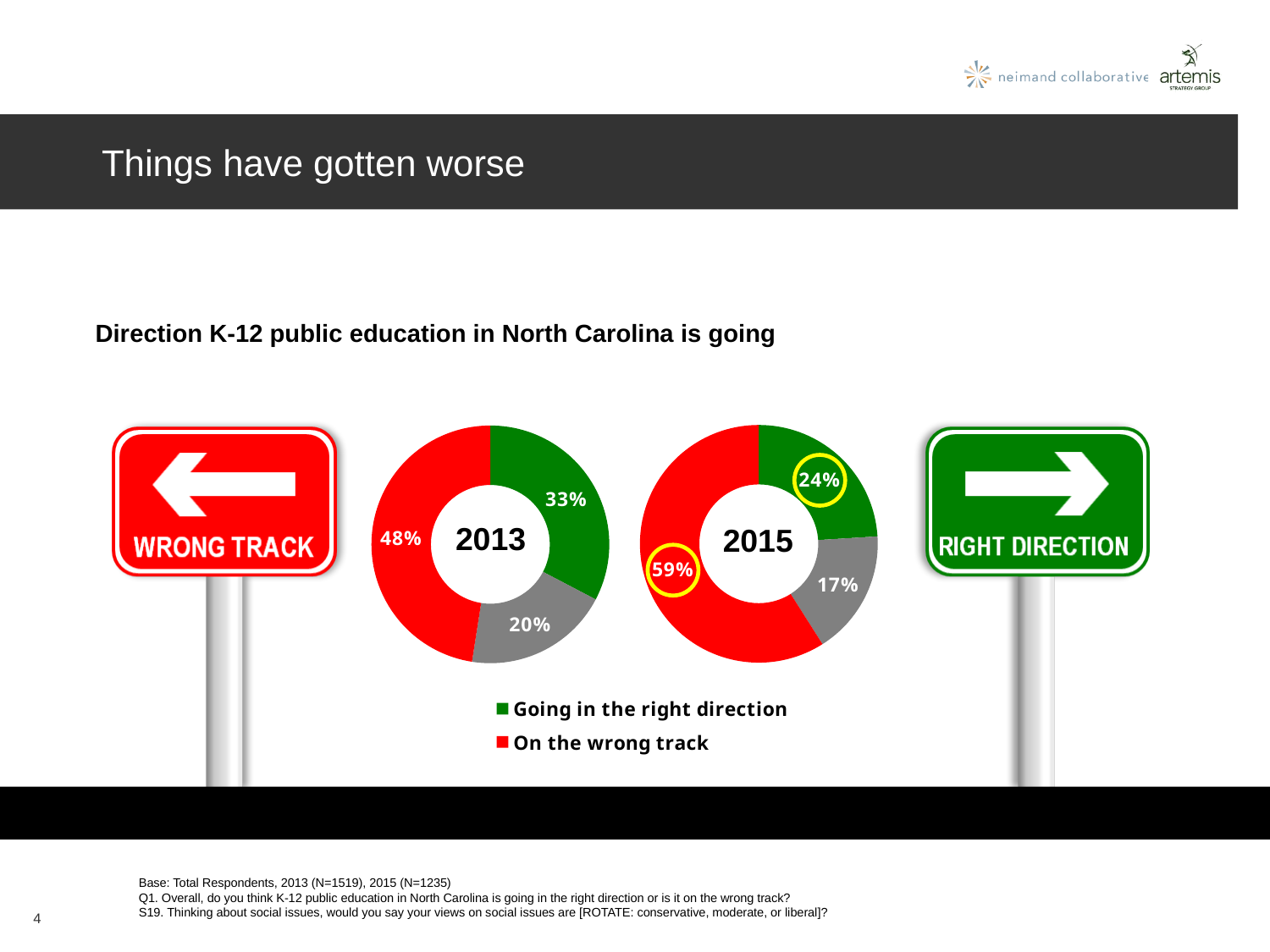
In the 2015 donut chart, what percentage said K-12 public education is on the wrong track? 59% In the 2015 donut chart, which slice is the largest? On the wrong track In the 2015 donut chart, what percentage said K-12 public education is going in the right direction? 24% In the 2013 donut chart, what percentage said K-12 public education is on the wrong track? 48% By how many percentage points did the 'Going in the right direction' share fall from the 2013 chart to the 2015 chart? 9 percentage points In the 2013 donut chart, which slice is the smallest? The gray slice (20%) How many entries does the legend list? 2 In the 2015 donut chart, what is the value of the gray slice? 17% What type of chart is used to show the 2013 and 2015 results? Donut (pie) chart Which is larger: the 'Going in the right direction' share in the 2013 chart or in the 2015 chart? 2013 By how many percentage points did the 'On the wrong track' share increase from the 2013 chart to the 2015 chart? 11 percentage points In the 2013 donut chart, what percentage said K-12 public education is going in the right direction? 33%